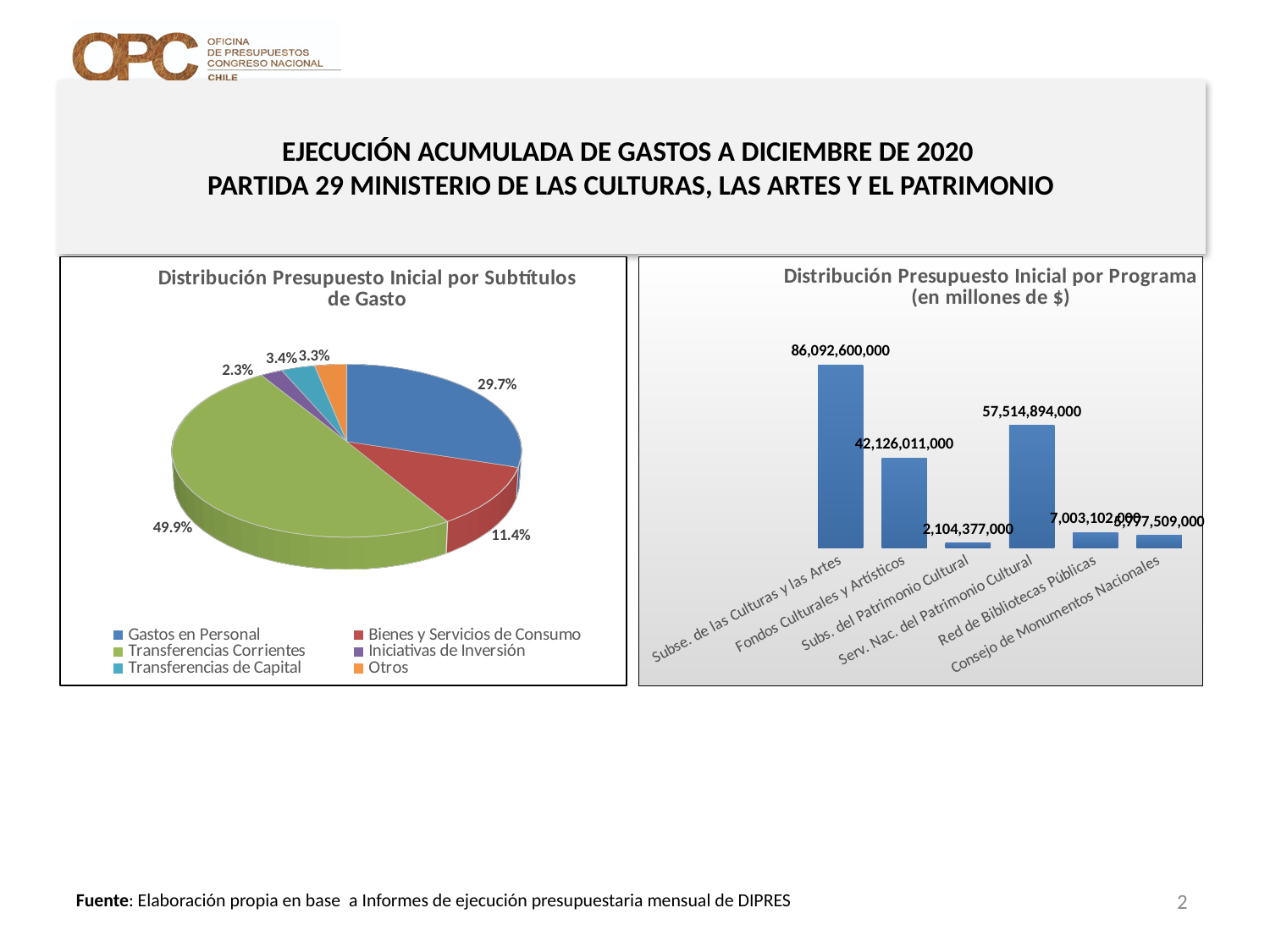
In the 'Distribución Presupuesto Inicial por Programa' bar chart, which is larger: Fondos Culturales y Artísticos or Serv. Nac. del Patrimonio Cultural? Serv. Nac. del Patrimonio Cultural In the 'Distribución Presupuesto Inicial por Subtítulos de Gasto' pie chart, what share does Transferencias Corrientes have? 49.9% How many categories does the legend of the 'Distribución Presupuesto Inicial por Subtítulos de Gasto' pie chart list? 6 In the 'Distribución Presupuesto Inicial por Programa' bar chart, which program has the lowest value? Subs. del Patrimonio Cultural What kind of chart is the 'Distribución Presupuesto Inicial por Subtítulos de Gasto' chart? Pie chart In the 'Distribución Presupuesto Inicial por Subtítulos de Gasto' pie chart, what share does Gastos en Personal have? 29.7% In the 'Distribución Presupuesto Inicial por Subtítulos de Gasto' pie chart, how many percentage points larger is Transferencias Corrientes than Gastos en Personal? 20.2 In the 'Distribución Presupuesto Inicial por Programa' bar chart, what is the value for Subse. de las Culturas y las Artes? 86,092,600,000 In the 'Distribución Presupuesto Inicial por Subtítulos de Gasto' pie chart, which category has the largest share? Transferencias Corrientes In the 'Distribución Presupuesto Inicial por Programa' bar chart, which program has the highest value? Subse. de las Culturas y las Artes In the 'Distribución Presupuesto Inicial por Subtítulos de Gasto' pie chart, which category has the smallest share? Iniciativas de Inversión What kind of chart is the 'Distribución Presupuesto Inicial por Programa' chart? Bar chart